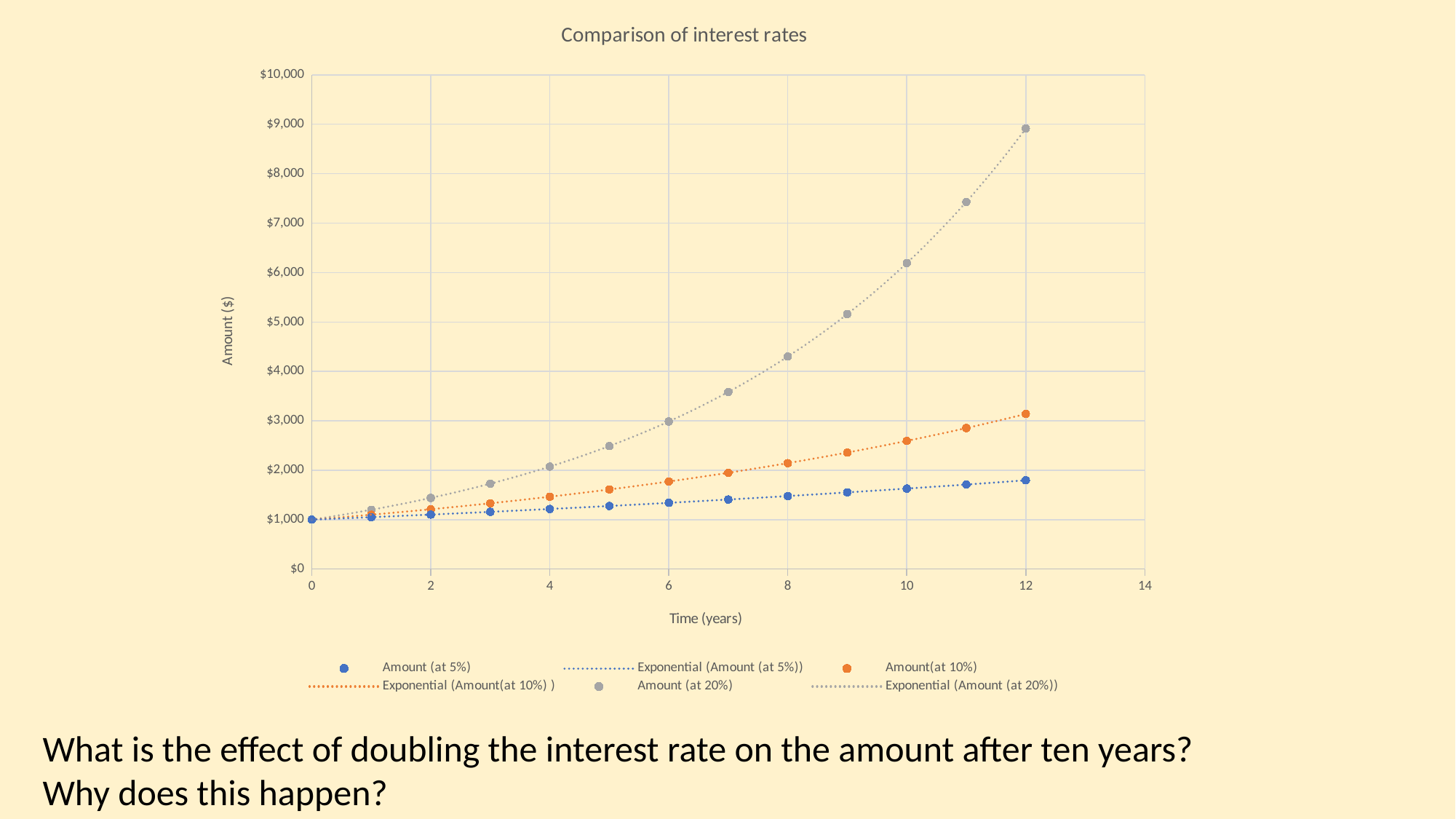
Which series has the highest value at 12 years? Amount (at 20%) What is the title of the chart? Comparison of interest rates What kind of chart is shown on the slide? Scatter chart Is the value for Amount (at 5%) at 12 years greater or less than $2,000? less How many entries does the chart's legend list? 6 At 10 years, which is larger: Amount (at 20%) or Amount(at 10%)? Amount (at 20%) What is the value of Amount (at 20%) at time 0 years? $1,000 Which series has the lowest value at 12 years? Amount (at 5%) What is the label of the vertical axis? Amount ($) Do the values for Amount (at 20%) rise or fall as time increases? Rise Is the value for Amount (at 20%) at 8 years greater or less than $4,000? greater How many data points are plotted for the Amount (at 5%) series? 13